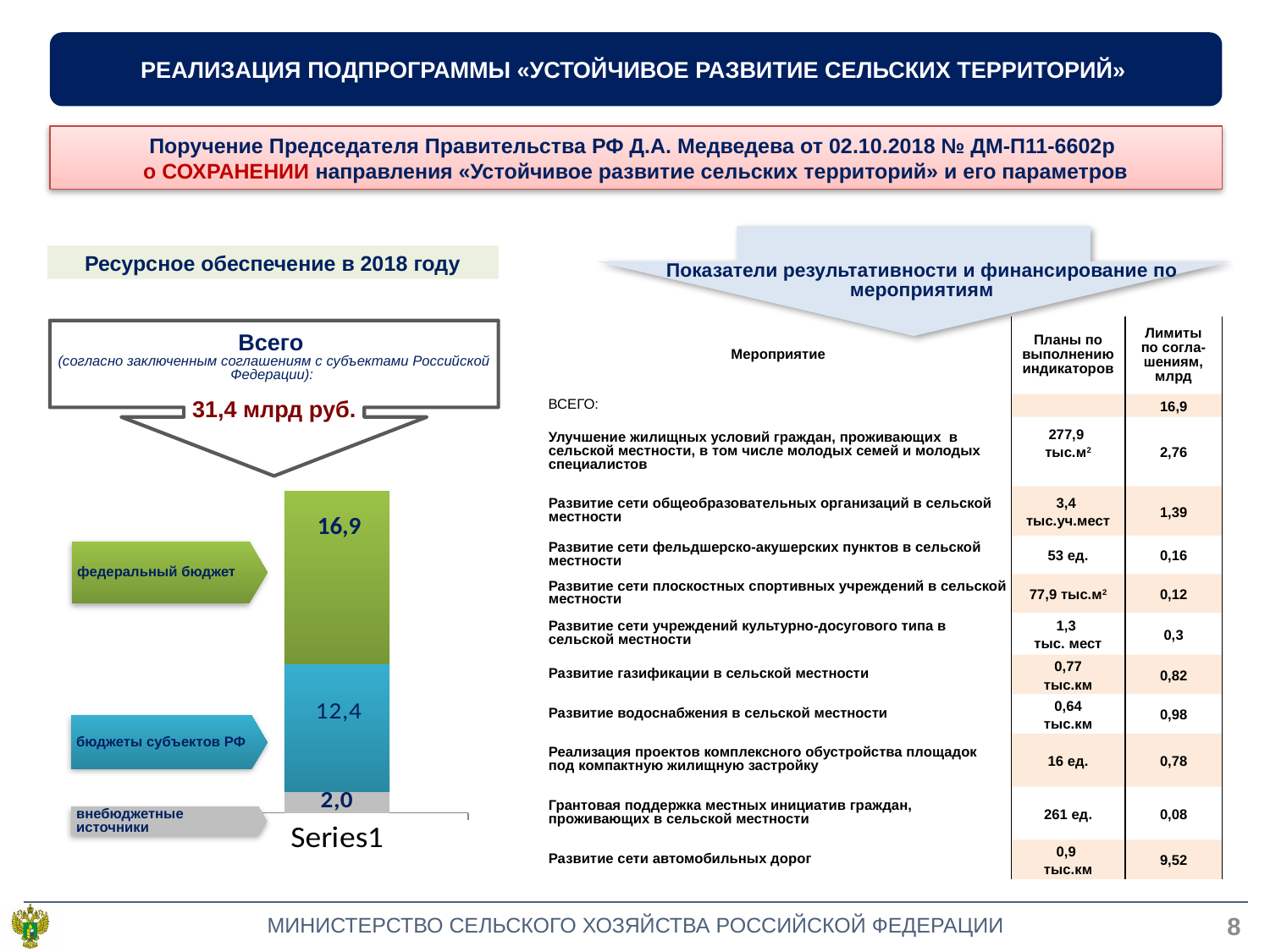
What is the value of the segment labelled "внебюджетные источники" in the stacked bar? 2,0 What is the difference between the "федеральный бюджет" segment and the "бюджеты субъектов РФ" segment? 4,5 What is the value of the segment labelled "бюджеты субъектов РФ" in the stacked bar? 12,4 Which is larger in the stacked bar: "федеральный бюджет" or "бюджеты субъектов РФ"? федеральный бюджет Which segment of the stacked bar has the smallest value? внебюджетные источники What is the difference between the "бюджеты субъектов РФ" segment and the "внебюджетные источники" segment? 10,4 How many segments make up the stacked bar? 3 Which segment of the stacked bar has the largest value? федеральный бюджет What is the value of the segment labelled "федеральный бюджет" in the stacked bar? 16,9 What is the category label shown on the x axis of the stacked bar chart? Series1 What type of chart is shown under "Ресурсное обеспечение в 2018 году"? stacked bar chart